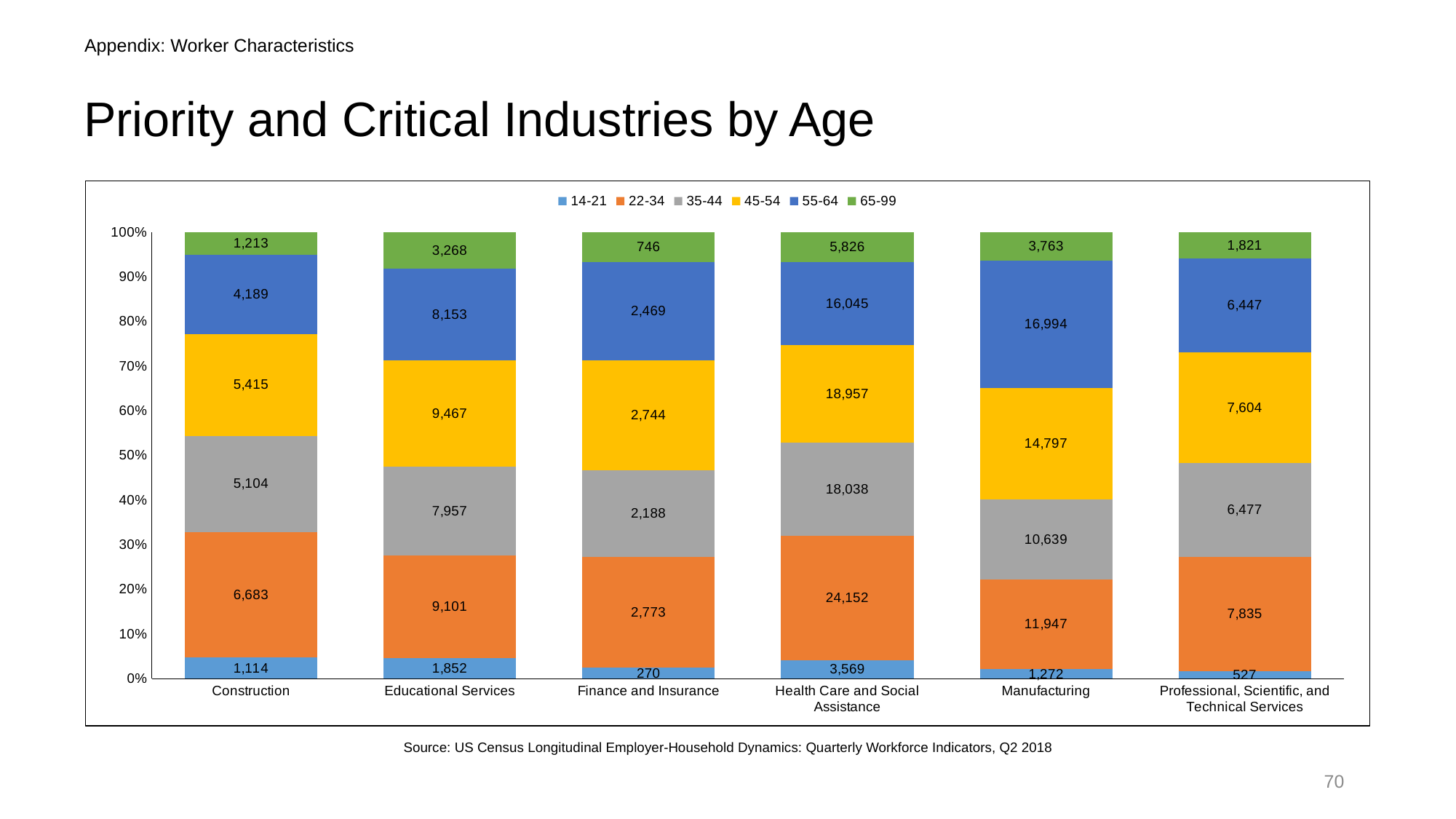
What is the value for the 55-64 age group in Manufacturing? 16,994 Which industry has the highest value for the 22-34 age group? Health Care and Social Assistance How many industries are shown on the x axis? 6 What is the difference between the 22-34 values for Health Care and Social Assistance and Manufacturing? 12,205 Which is larger in Manufacturing: the 45-54 value or the 55-64 value? 55-64 What is the value for the 65-99 age group in Educational Services? 3,268 What is the value for the 14-21 age group in Finance and Insurance? 270 How many age groups does the legend list? 6 What kind of chart is shown on the slide? Stacked bar chart What is the value for the 22-34 age group in Health Care and Social Assistance? 24,152 Which industry has the lowest value for the 14-21 age group? Finance and Insurance What is the total of all age groups for the Construction bar? 23,718